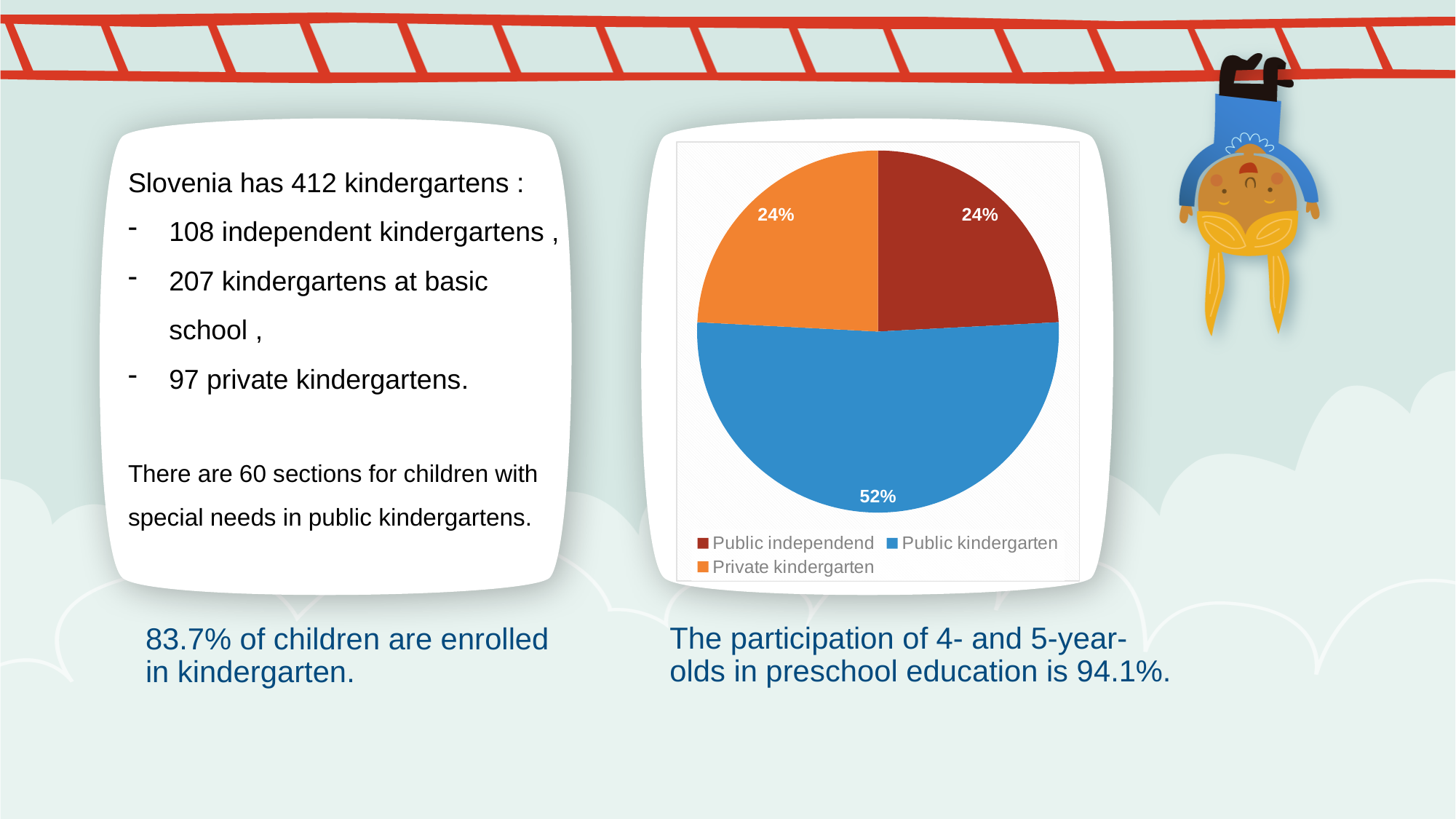
What colour is the Private kindergarten slice? orange How many entries does the legend list? 3 What share of the pie does Public independend have? 24% What is the difference in percentage points between Public kindergarten and Private kindergarten? 28 How many slices does the pie chart have? 3 Is the share for Public kindergarten greater or less than 50%? greater Which is larger, the slice for Public kindergarten or the slice for Public independend? Public kindergarten Which category has the largest slice of the pie? Public kindergarten What kind of chart is shown on the slide? pie chart What share of the pie does Private kindergarten have? 24% What colour is the Public kindergarten slice? blue What share of the pie does Public kindergarten have? 52%